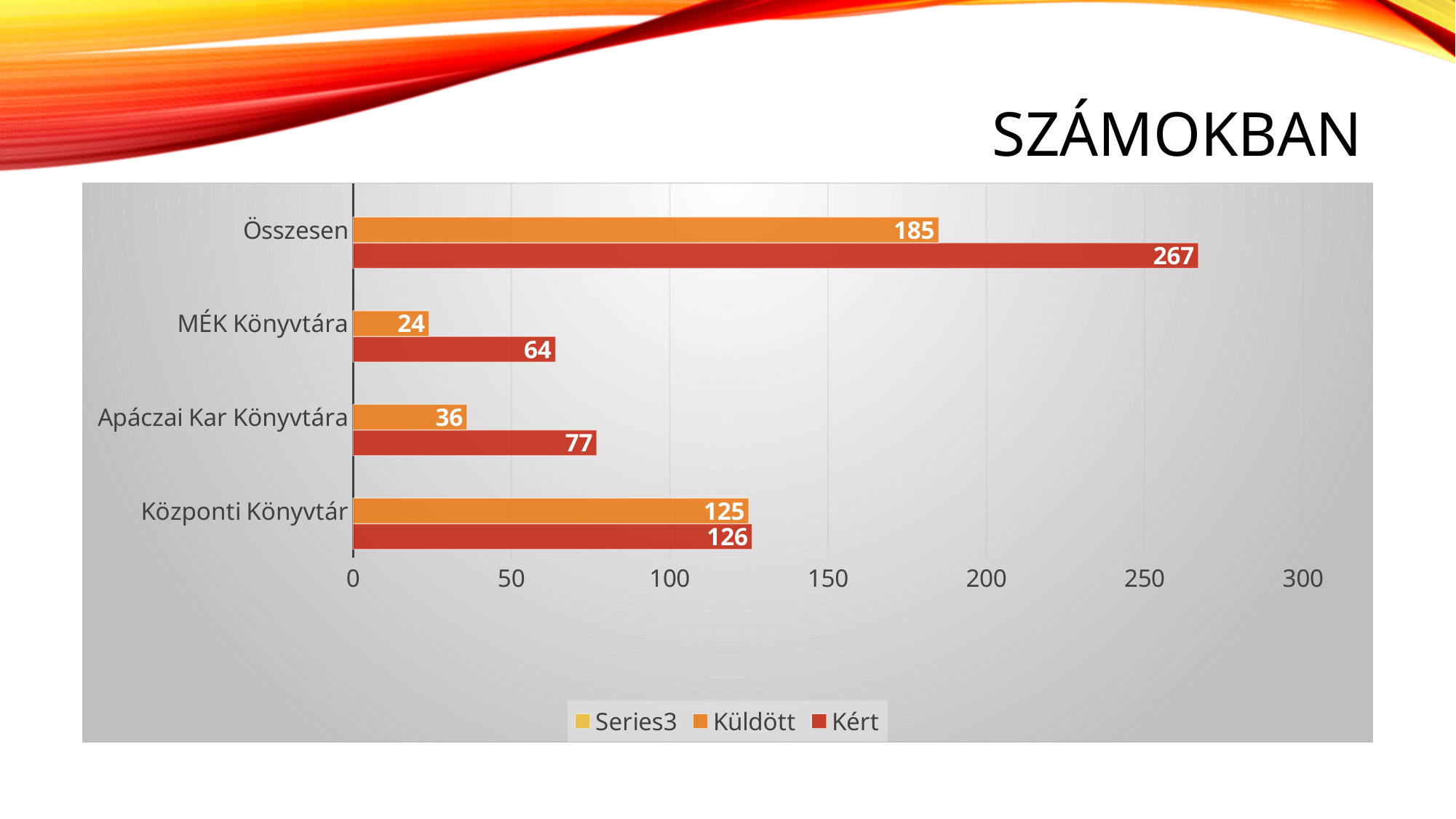
What is the Küldött value for MÉK Könyvtára? 24 Which is larger for Apáczai Kar Könyvtára, the Kért value or the Küldött value? Kért What is the Küldött value for Központi Könyvtár? 125 How many categories are shown on the chart? 4 Which category has the highest Kért value? Összesen Which category has the lowest Küldött value? MÉK Könyvtára What kind of chart is shown on the slide? Bar chart What is the difference between the Kért and Küldött values for Összesen? 82 How many series does the legend list? 3 What is the Kért value for Összesen? 267 What is the Kért value for Apáczai Kar Könyvtára? 77 What is the title of the slide? SZÁMOKBAN